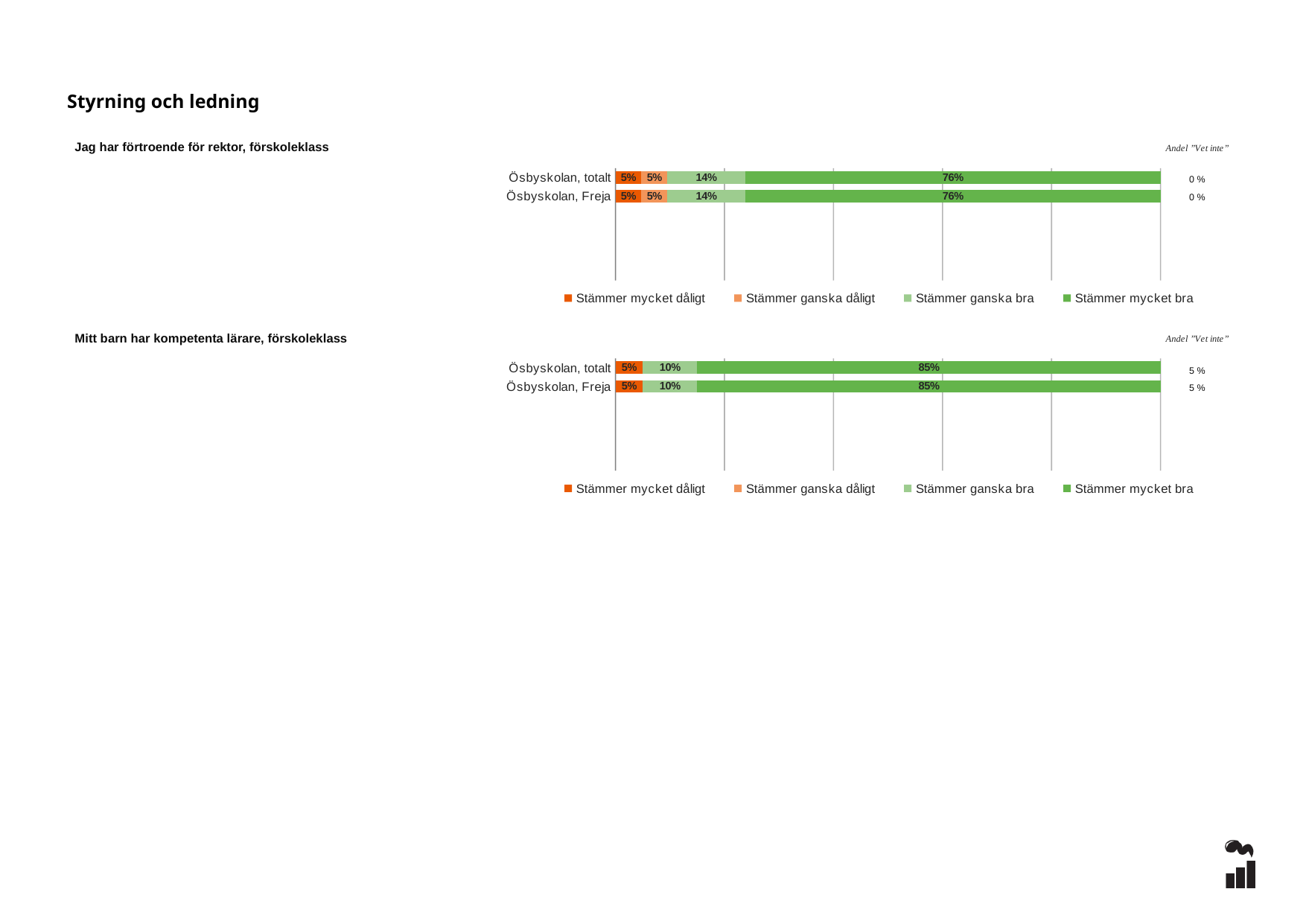
In the chart "Jag har förtroende för rektor, förskoleklass", what is the value for "Stämmer ganska bra" for Ösbyskolan, Freja? 14% How many categories (rows) are shown in the chart "Jag har förtroende för rektor, förskoleklass"? 2 In the chart "Mitt barn har kompetenta lärare, förskoleklass", what is the value for "Stämmer ganska bra" for Ösbyskolan, Freja? 10% In the chart "Jag har förtroende för rektor, förskoleklass", what is the difference between "Stämmer mycket bra" and "Stämmer ganska bra" for Ösbyskolan, totalt? 62% In the chart "Mitt barn har kompetenta lärare, förskoleklass", which response category has the lowest value for Ösbyskolan, Freja? Stämmer ganska dåligt How many series does the legend list in the chart "Mitt barn har kompetenta lärare, förskoleklass"? 4 What kind of chart is "Jag har förtroende för rektor, förskoleklass"? Stacked bar chart In the chart "Jag har förtroende för rektor, förskoleklass", what is the value for "Stämmer mycket bra" for Ösbyskolan, totalt? 76% Which is larger: "Stämmer mycket bra" for Ösbyskolan, totalt in the chart "Mitt barn har kompetenta lärare, förskoleklass" or in the chart "Jag har förtroende för rektor, förskoleklass"? Mitt barn har kompetenta lärare, förskoleklass In the chart "Mitt barn har kompetenta lärare, förskoleklass", what is the value for "Stämmer mycket bra" for Ösbyskolan, totalt? 85% In the chart "Jag har förtroende för rektor, förskoleklass", which response category has the highest value for Ösbyskolan, totalt? Stämmer mycket bra In the chart "Mitt barn har kompetenta lärare, förskoleklass", what is the "Andel Vet inte" value shown for Ösbyskolan, totalt? 5 %